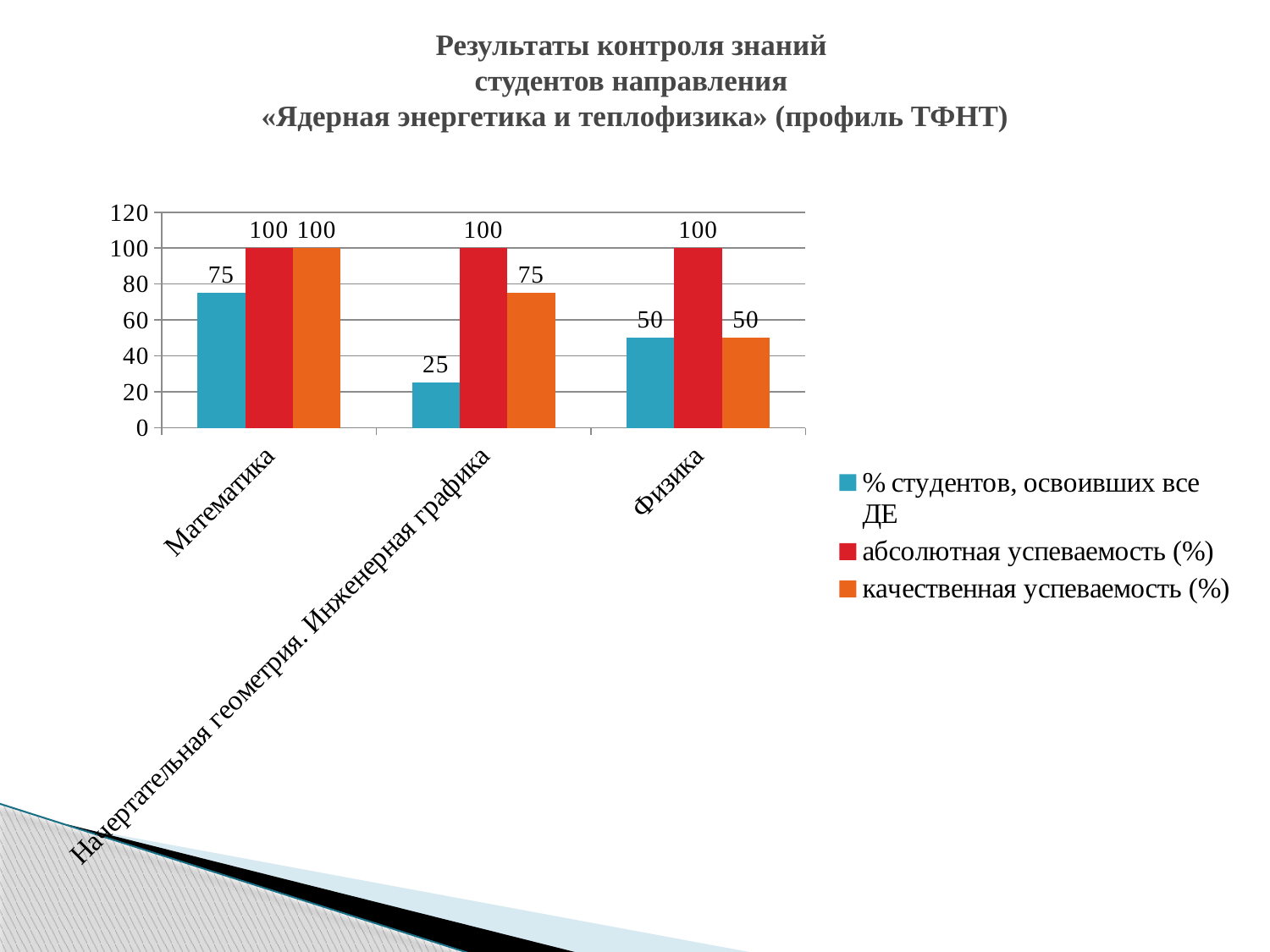
Which is larger for Начертательная геометрия. Инженерная графика: "% студентов, освоивших все ДЕ" or "качественная успеваемость (%)"? качественная успеваемость (%) Which series is shown in red in the legend? абсолютная успеваемость (%) Which category has the lowest value for "% студентов, освоивших все ДЕ"? Начертательная геометрия. Инженерная графика How many categories are shown on the x axis? 3 What is the value of "% студентов, освоивших все ДЕ" for Начертательная геометрия. Инженерная графика? 25 What is the value of "качественная успеваемость (%)" for Начертательная геометрия. Инженерная графика? 75 What is the value of "% студентов, освоивших все ДЕ" for Математика? 75 Which category has the highest value for "% студентов, освоивших все ДЕ"? Математика How many series does the legend list? 3 What is the value of "качественная успеваемость (%)" for Физика? 50 What type of chart is shown on the slide? bar chart What is the difference between "абсолютная успеваемость (%)" and "качественная успеваемость (%)" for Физика? 50